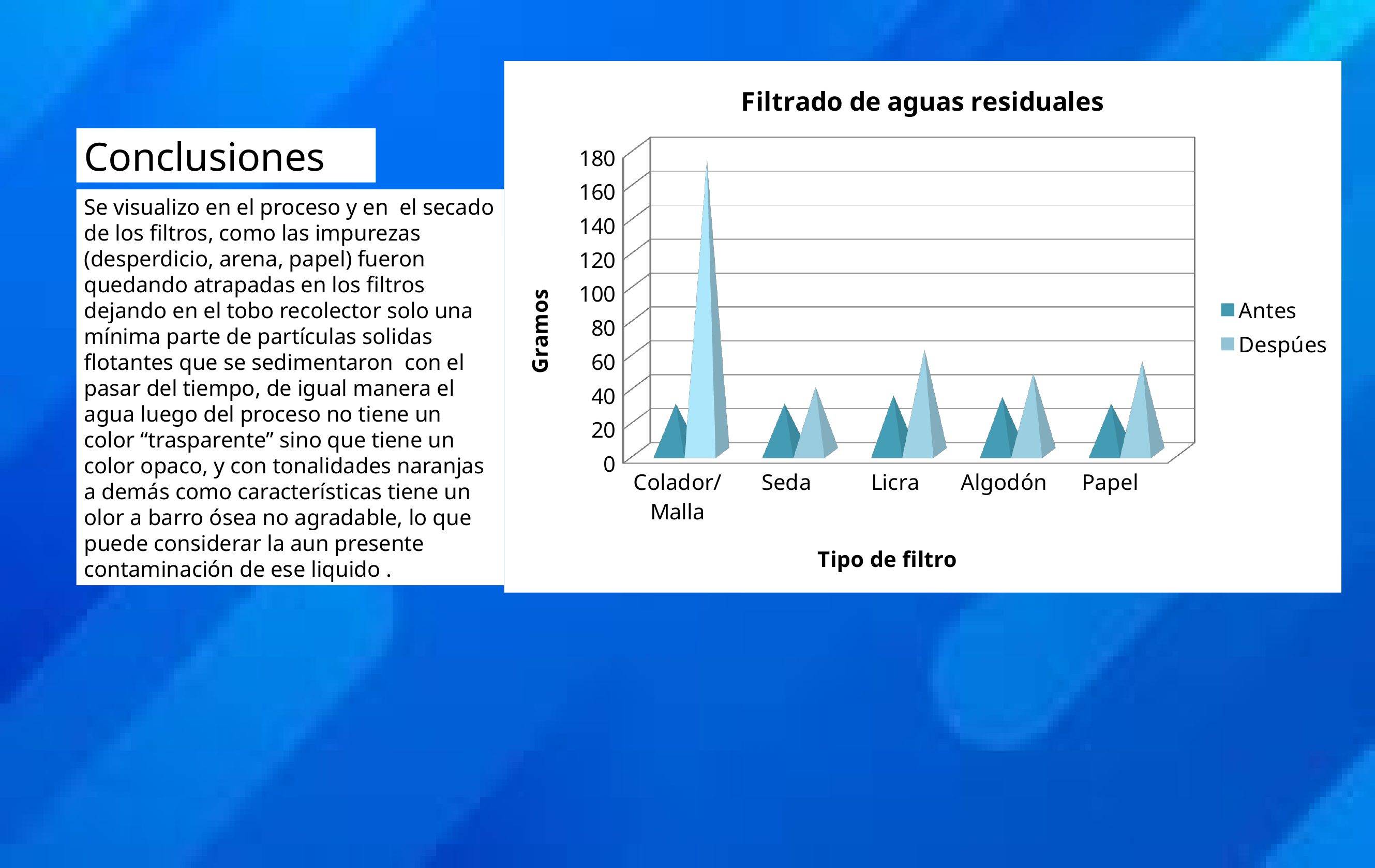
How many filter types (categories) are shown on the x axis? 5 What kind of chart is shown on the slide? bar chart Is the Antes value for Seda greater or less than 60? less For Colador/Malla, which is larger: the Antes value or the Despúes value? Despúes Is the Despúes value for Colador/Malla greater or less than 140? greater Which filter type has the highest Despúes value? Colador/Malla Is the Despúes value for Licra greater or less than 100? less What is the label of the vertical axis? Gramos How many series does the legend list? 2 What is the title of the chart? Filtrado de aguas residuales Which filter type has the lowest Despúes value? Seda Which is larger: the Despúes value for Licra or the Despúes value for Seda? Licra